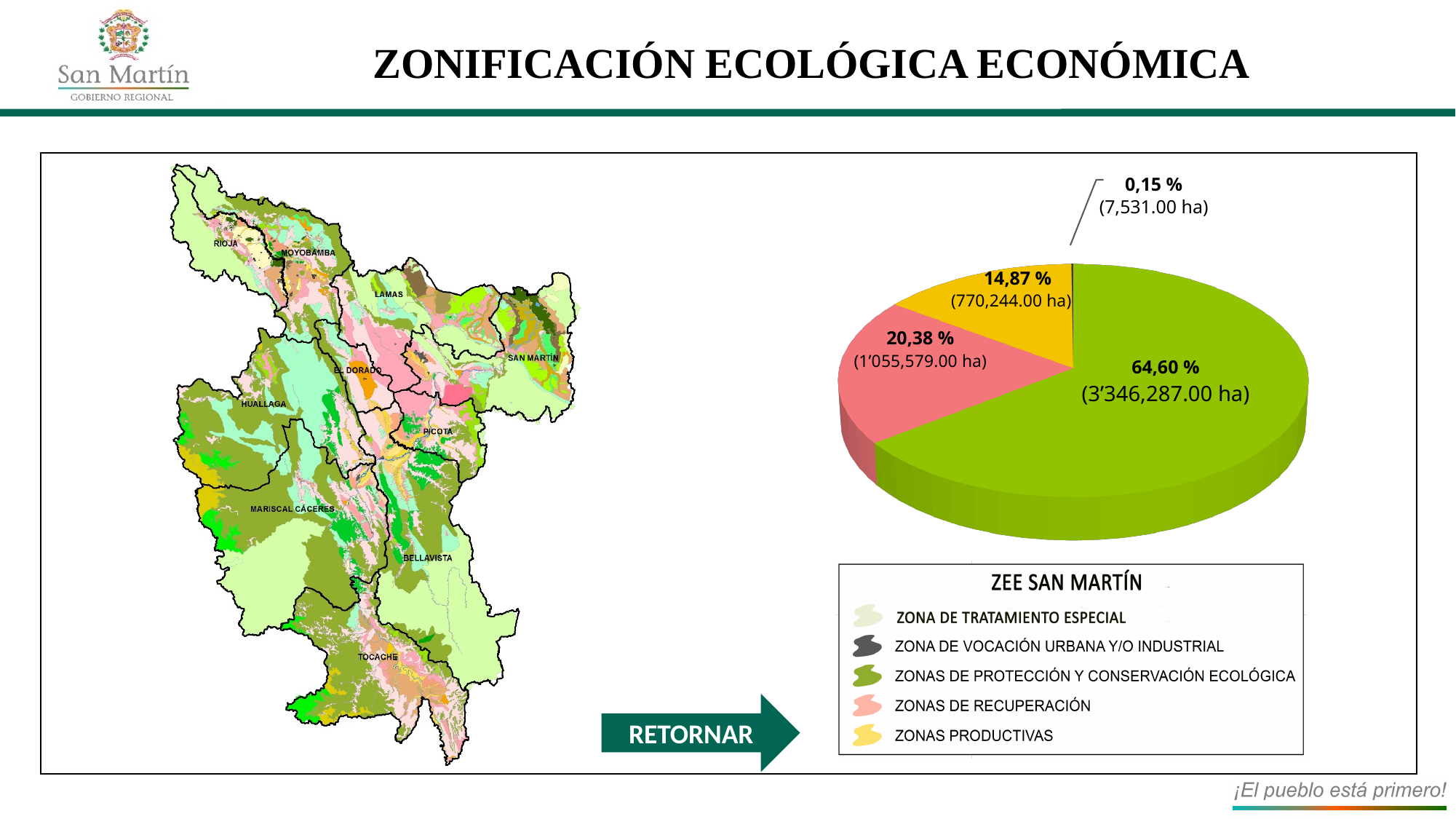
How many hectares are shown for the 0,15 % slice of the pie chart? 7,531.00 ha What percentage of the pie chart corresponds to Zonas de protección y conservación ecológica? 64,60 % What kind of chart is shown on the right side of the slide? pie chart Which slice is larger in the pie chart: Zonas de recuperación or Zonas productivas? Zonas de recuperación What percentage does the pie chart show for Zonas productivas? 14,87 % What is the title shown at the top of the pie chart's legend? ZEE SAN MARTÍN What is the difference in percentage points between the Zonas de protección y conservación ecológica slice and the Zonas de recuperación slice? 44,22 How many percentage labels are shown on the pie chart? 4 What is the smallest percentage labelled on the pie chart? 0,15 % Which zone has the largest slice in the pie chart? Zonas de protección y conservación ecológica How many hectares are shown for Zonas de recuperación in the pie chart? 1’055,579.00 ha How many entries does the legend of the pie chart list? 5